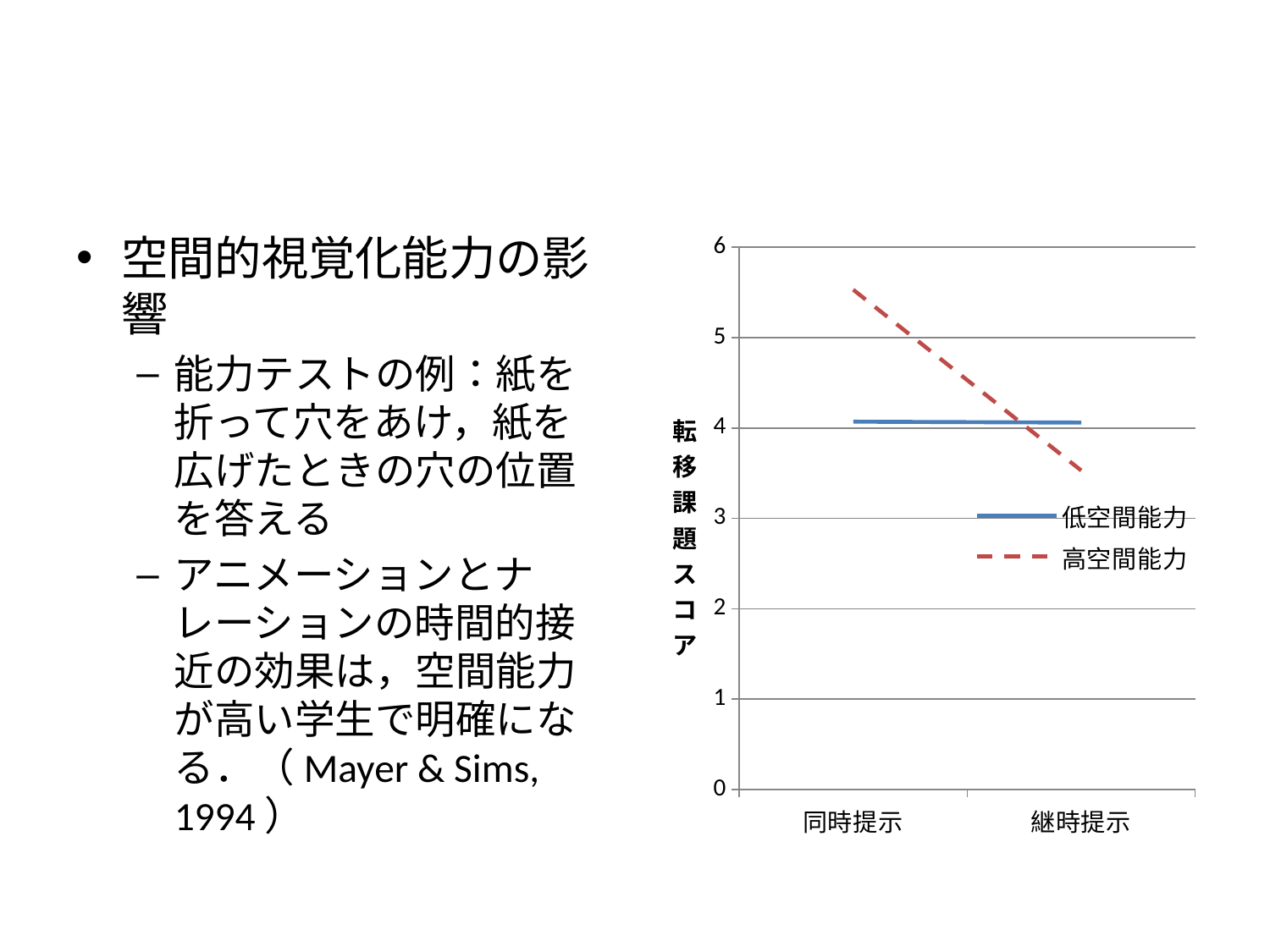
Is the value for 低空間能力 at 同時提示 greater or less than 3? greater How many series does the legend list? 2 At 同時提示, which series has the higher value, 低空間能力 or 高空間能力? 高空間能力 Is the value for 高空間能力 at 同時提示 greater or less than 5? greater Which series does the red dashed line represent? 高空間能力 At 継時提示, which series has the higher value, 低空間能力 or 高空間能力? 低空間能力 What is the label of the vertical axis? 転移課題スコア How many categories are shown on the x axis? 2 For the 高空間能力 series, which category has the highest value? 同時提示 What kind of chart is shown on the slide? line chart Is the value for 高空間能力 at 継時提示 greater or less than 4? less Does the value for 高空間能力 rise or fall from 同時提示 to 継時提示? fall